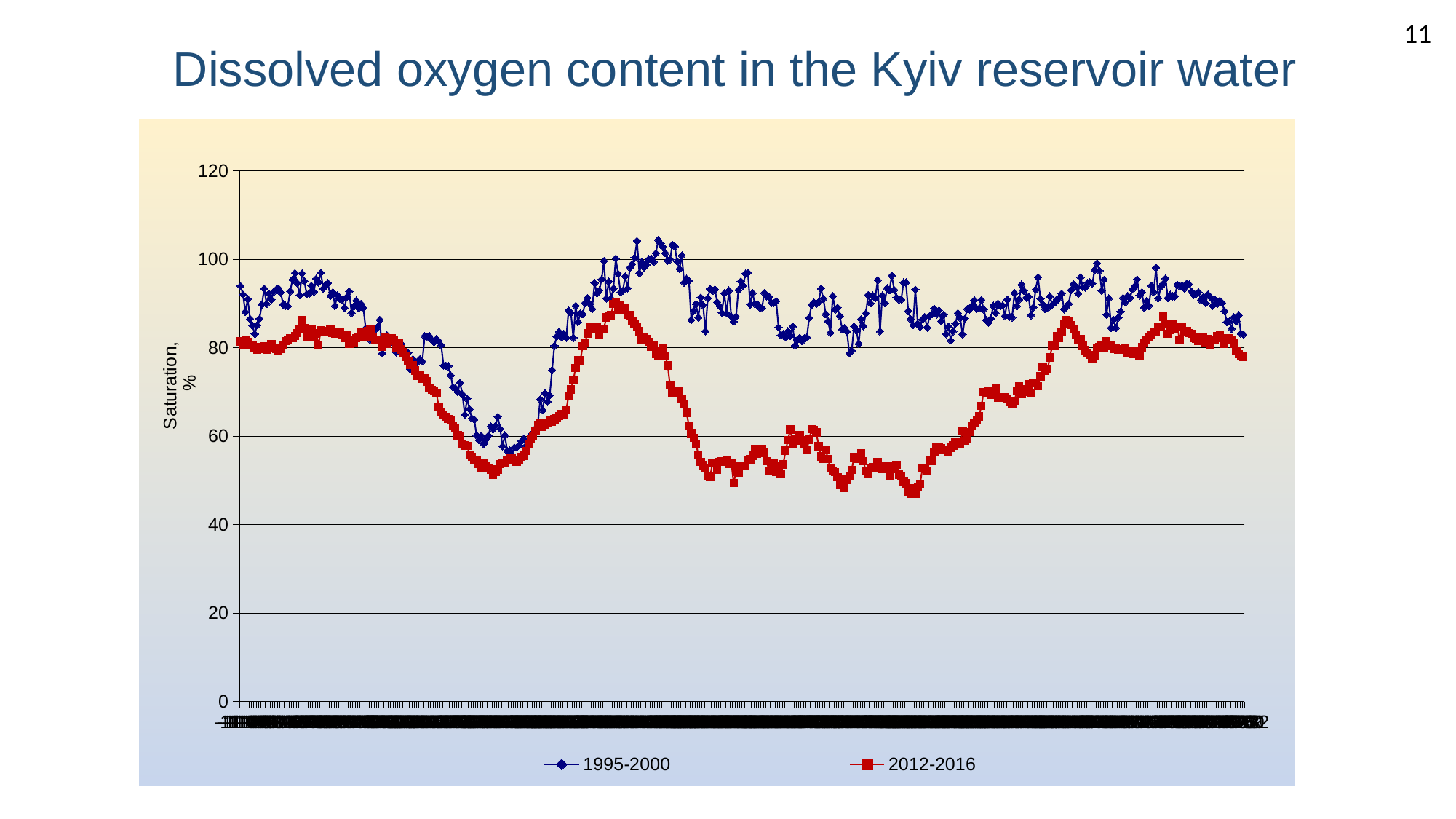
Is the highest value of the 2012-2016 series greater or less than 100? less What kind of chart is shown on the slide? line chart Is the lowest value of the 1995-2000 series greater or less than 80? less Which series reaches the highest value on the chart, 1995-2000 or 2012-2016? 1995-2000 What are the two series named in the legend? 1995-2000 and 2012-2016 How many series does the legend list? 2 Is the lowest value of the 2012-2016 series greater or less than 60? less Over most of the chart, which series has higher saturation values, 1995-2000 or 2012-2016? 1995-2000 Which series drops to the lowest value on the chart, 1995-2000 or 2012-2016? 2012-2016 What is the label on the vertical axis? Saturation, % What is the maximum value shown on the vertical axis? 120